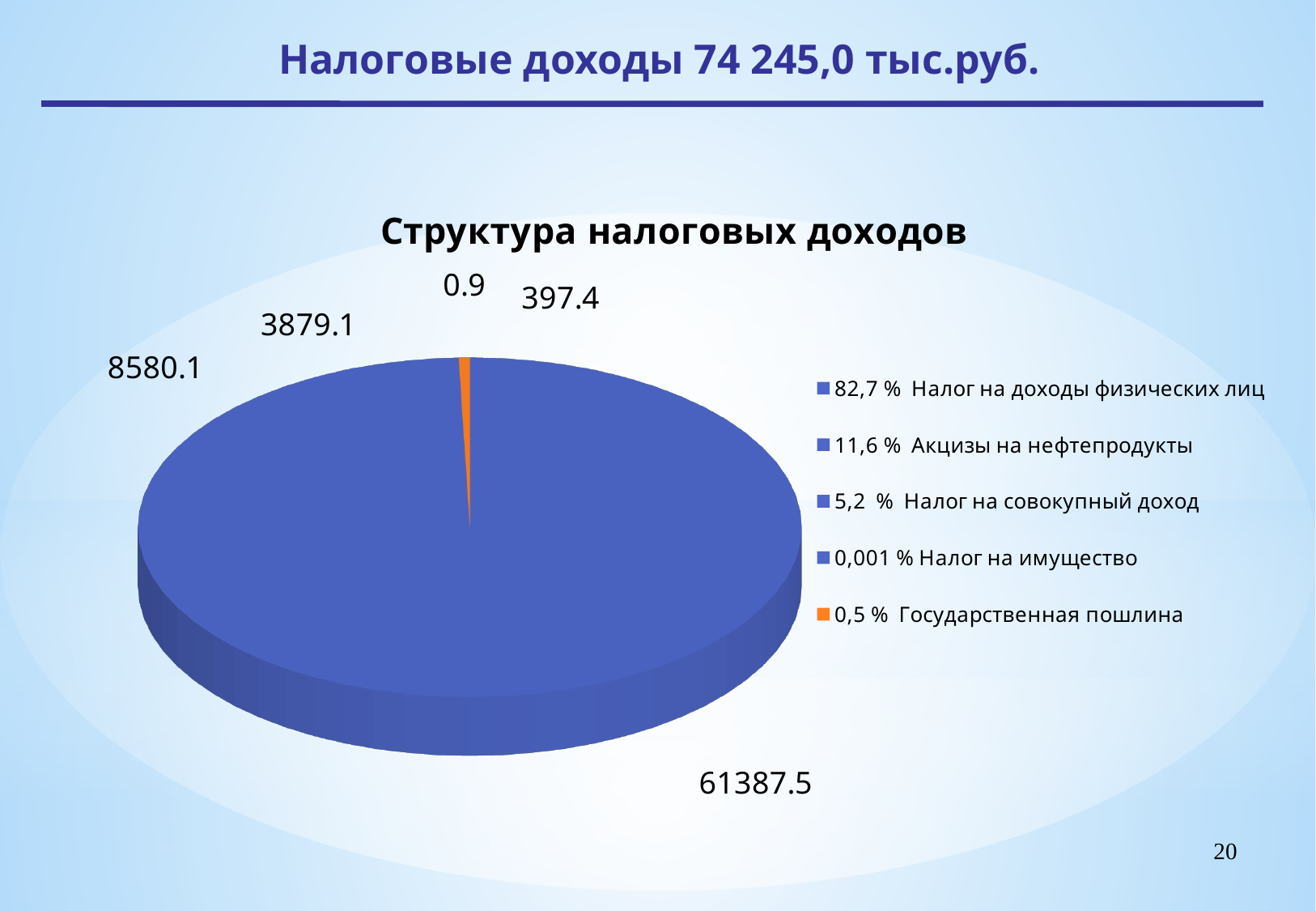
What kind of chart is shown on the slide? pie chart What is the largest data label value shown on the pie chart? 61387.5 What is the title of the chart? Структура налоговых доходов What share of tax revenues does Акцизы на нефтепродукты account for, according to the legend? 11,6 % What share does Государственная пошлина have, according to the legend? 0,5 % Which category has the largest slice of the pie? Налог на доходы физических лиц Which category has the smallest slice of the pie? Налог на имущество What share of tax revenues does Налог на доходы физических лиц account for, according to the legend? 82,7 % What is the difference between the data labels 8580.1 and 3879.1? 4701.0 How many categories does the legend of the pie chart list? 5 What is the smallest data label value shown on the pie chart? 0.9 Which legend entry is shown in orange? Государственная пошлина